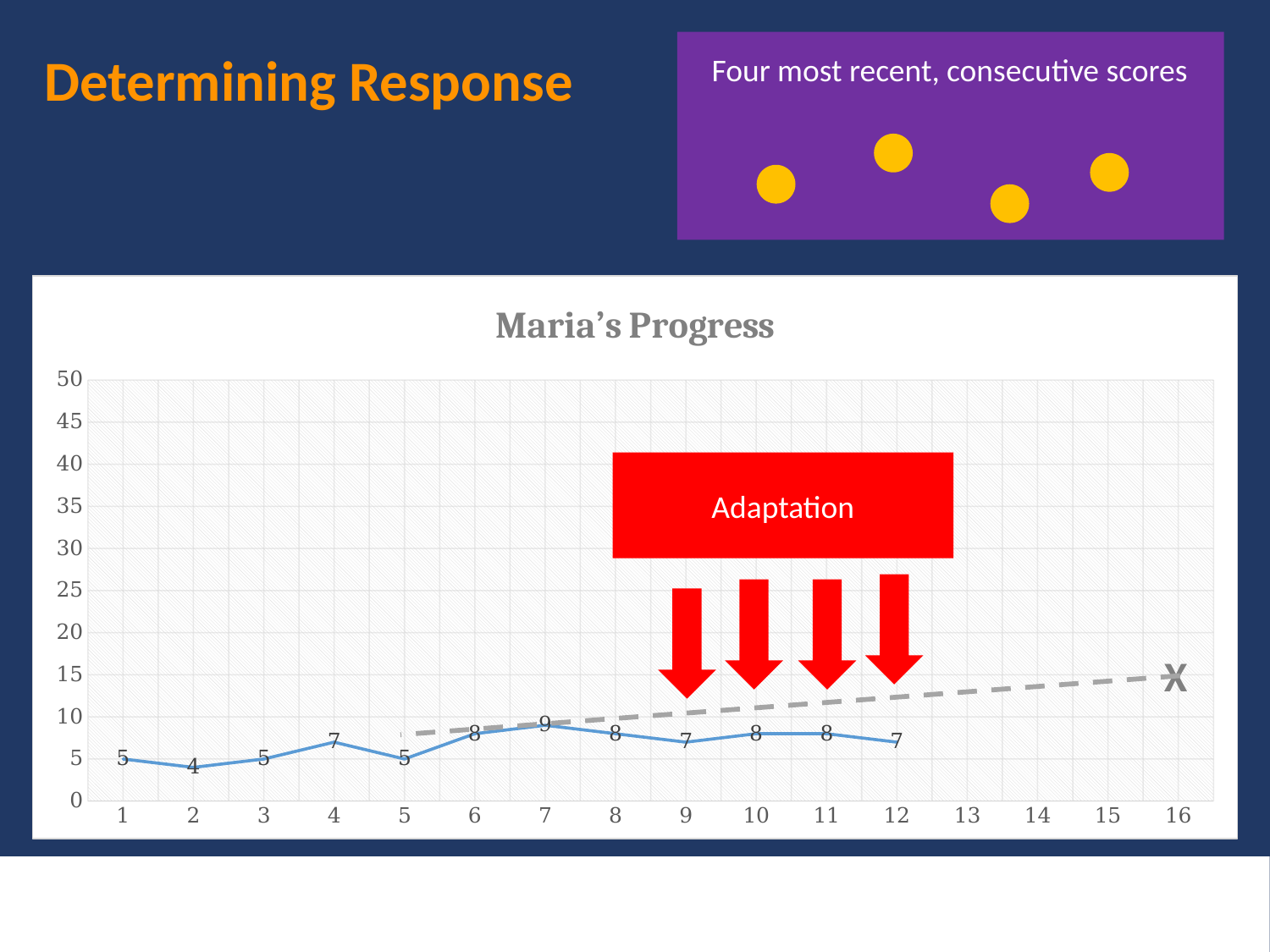
How many data points are plotted on Maria's progress line? 12 What is Maria's score at point 7? 9 What is Maria's score at point 2? 4 What type of chart is shown on the slide? line chart Which is larger, Maria's score at point 4 or her score at point 5? point 4 What is the title of the chart? Maria's Progress At which x-axis point is Maria's score lowest? 2 What is the highest value shown on the y-axis? 50 Is Maria's score at point 10 greater or less than 10? less What is the difference between Maria's score at point 7 and her score at point 2? 5 At which x-axis point is Maria's score highest? 7 What is Maria's score at point 12? 7